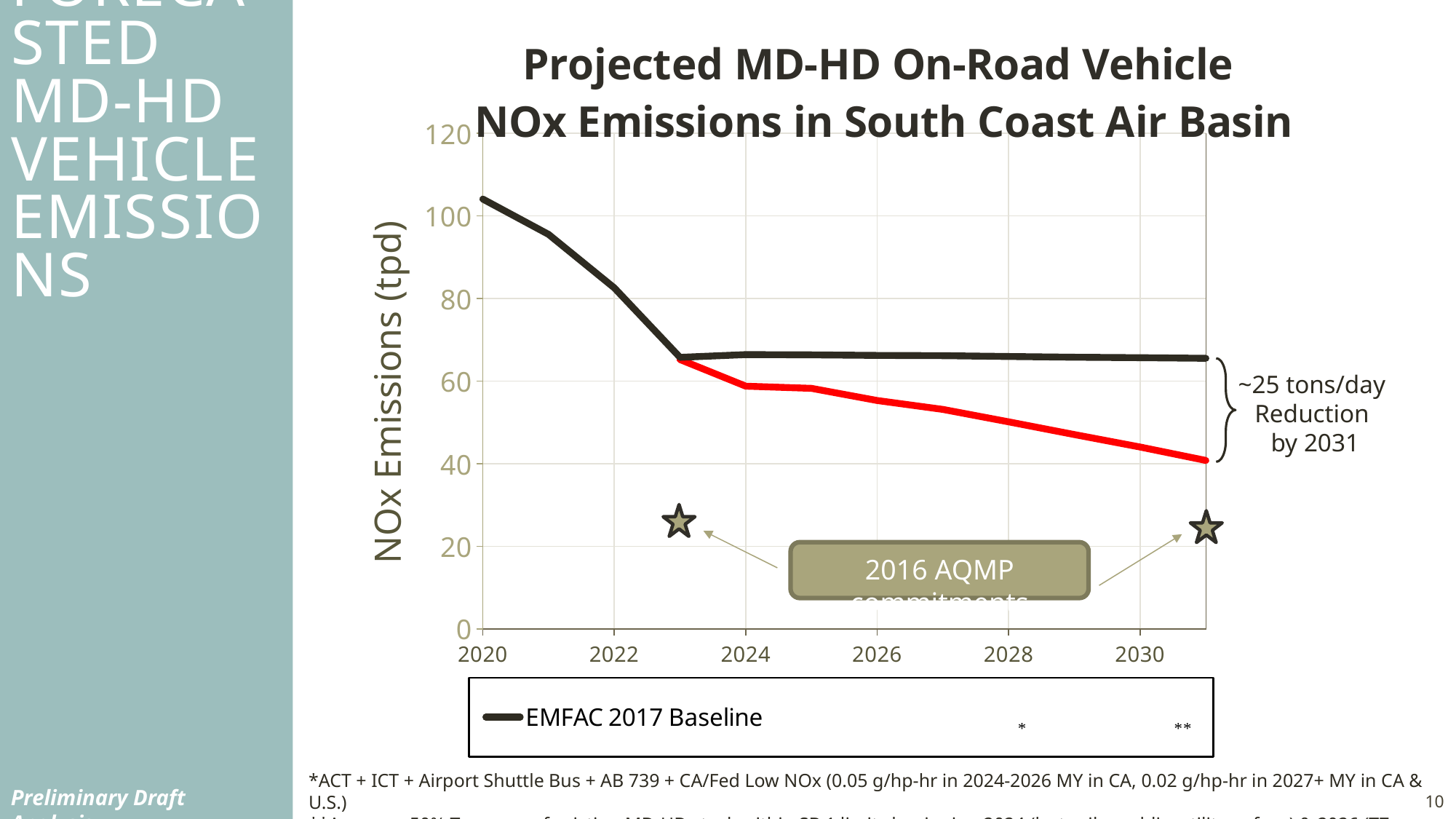
Is the EMFAC 2017 Baseline value in 2021 greater or less than 80? greater Is the EMFAC 2017 Baseline value in 2020 greater or less than 100? greater Is the red line's value in 2031 greater or less than 60? less What is the label of the vertical axis? NOx Emissions (tpd) In 2030, which line is higher: the EMFAC 2017 Baseline or the red line? EMFAC 2017 Baseline Does the red line rise or fall from 2023 to 2031? fall What kind of chart is shown on the slide? line chart What is the title of the chart? Projected MD-HD On-Road Vehicle NOx Emissions in South Coast Air Basin How many lines are plotted on the chart? 2 Does the EMFAC 2017 Baseline rise or fall from 2020 to 2023? fall